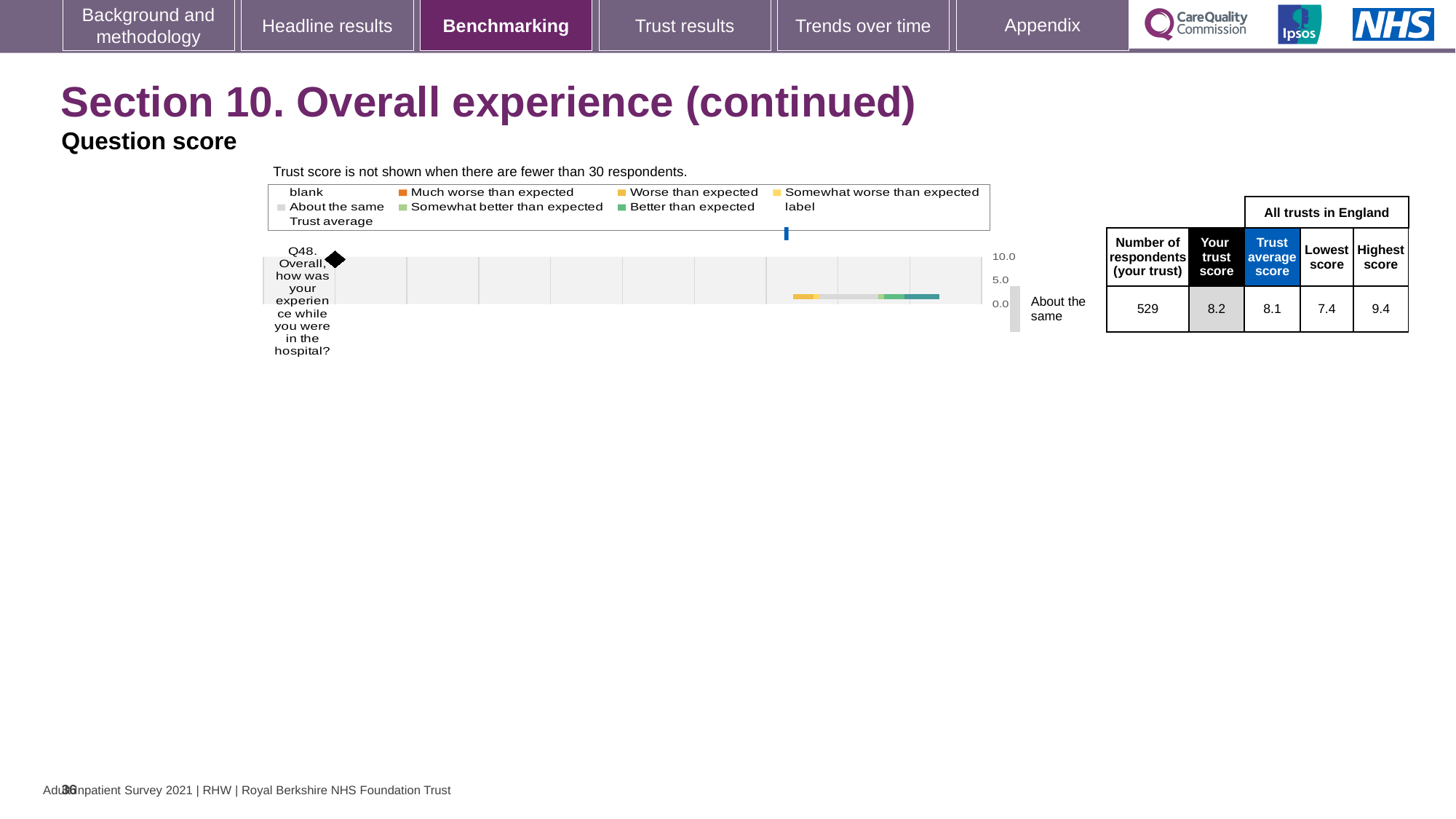
Which is larger for Q48: your trust score or the trust average score? Your trust score What is the trust average score for Q48 across all trusts in England? 8.1 What benchmark category is shown next to the Q48 bar? About the same What is the highest score for Q48 across all trusts in England? 9.4 What kind of chart is used to show the Q48 question score? bar chart What is the difference between the highest score and the lowest score for Q48? 2.0 What is the number of respondents (your trust) for Q48? 529 In the chart legend, what colour represents 'Much worse than expected'? orange What is the lowest score for Q48 across all trusts in England? 7.4 What is your trust score for Q48? 8.2 Which question is plotted in the question score chart? Q48. Overall, how was your experience while you were in the hospital? How many questions are plotted in the question score chart? 1